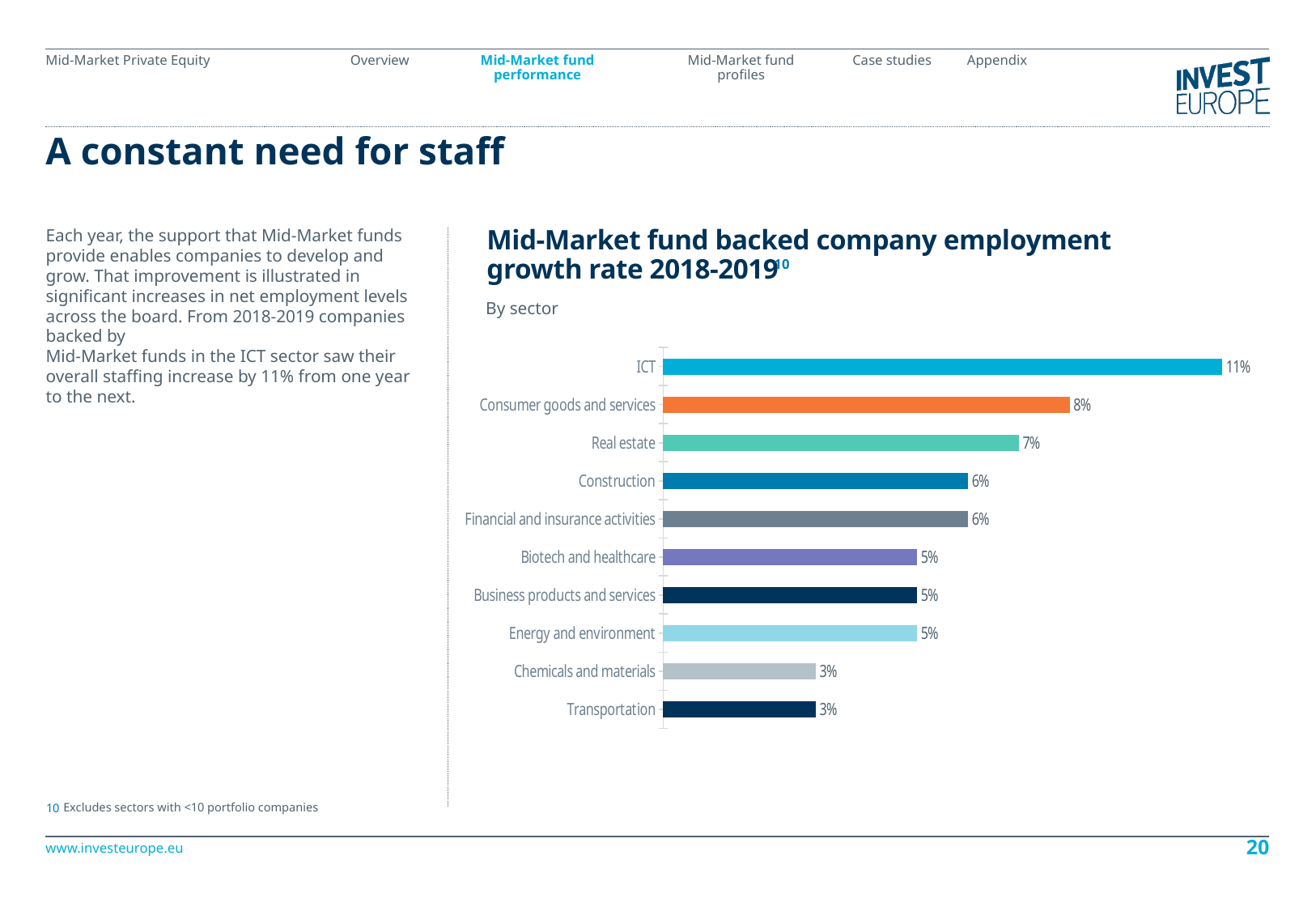
What is the employment growth rate for ICT? 11% What is the title of the chart? Mid-Market fund backed company employment growth rate 2018-2019 How many sectors are shown in the chart? 10 What is the difference between the employment growth rate for Consumer goods and services and for Transportation? 5% What is the difference between the employment growth rate for ICT and for Real estate? 4% What is the employment growth rate for Biotech and healthcare? 5% What kind of chart is shown on the slide? Bar chart Which sector has the highest employment growth rate? ICT Which has a higher employment growth rate, Energy and environment or Chemicals and materials? Energy and environment Which has a higher employment growth rate, Real estate or Construction? Real estate What is the employment growth rate for Chemicals and materials? 3% What is the employment growth rate for Consumer goods and services? 8%